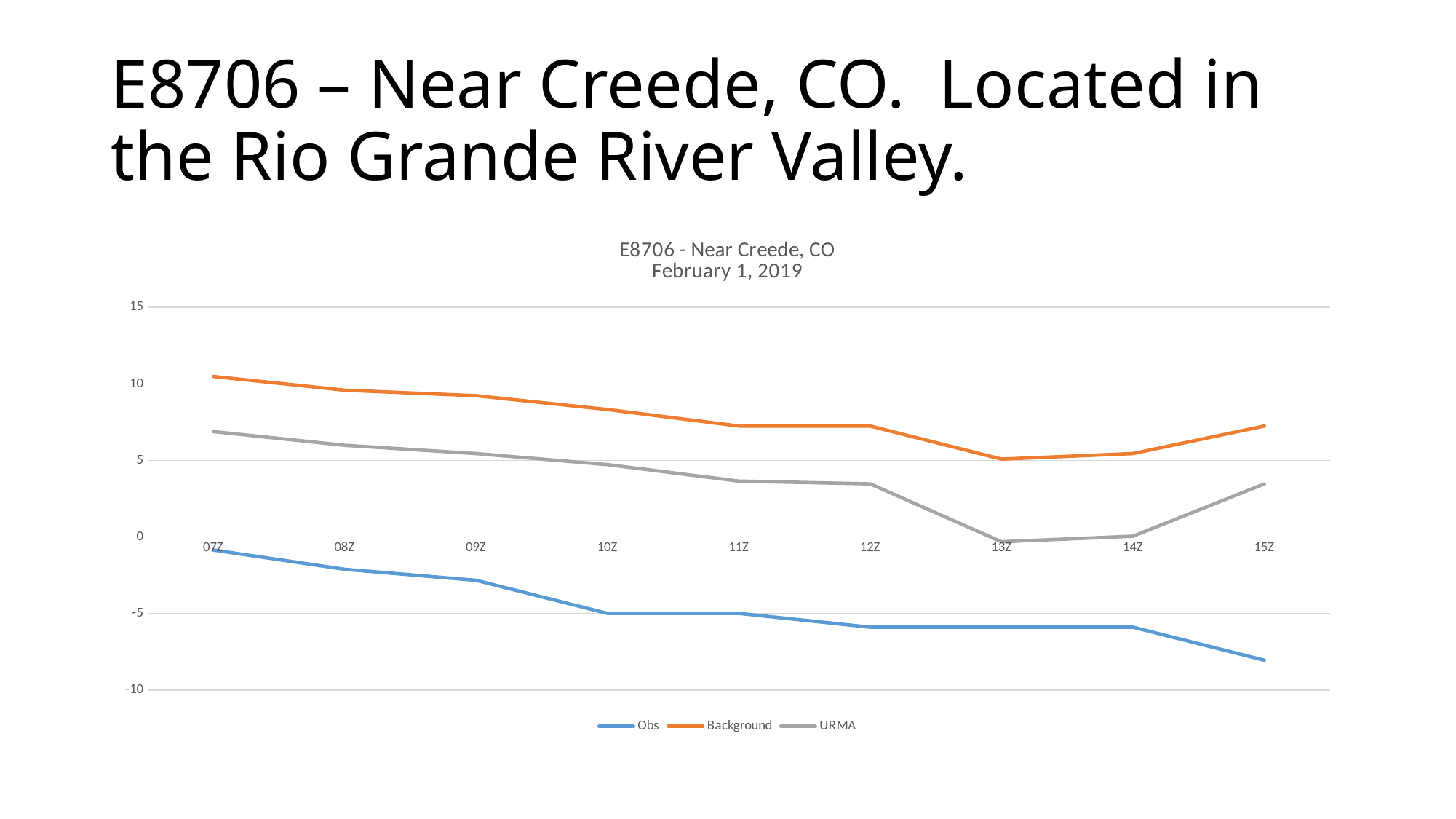
Is the Obs value at 15Z greater or less than -5? less Is the URMA value at 07Z greater or less than 5? greater Is the URMA value at 15Z greater or less than 5? less At which time is the Obs series lowest? 15Z At 12Z, which series has the larger value, Background or URMA? Background What kind of chart is shown on the slide? line chart How many series does the legend list? 3 At which time is the Background series highest? 07Z What is the title of the chart? E8706 - Near Creede, CO February 1, 2019 How many time points are plotted along the x axis? 9 Does the Obs series rise or fall from 07Z to 15Z? fall